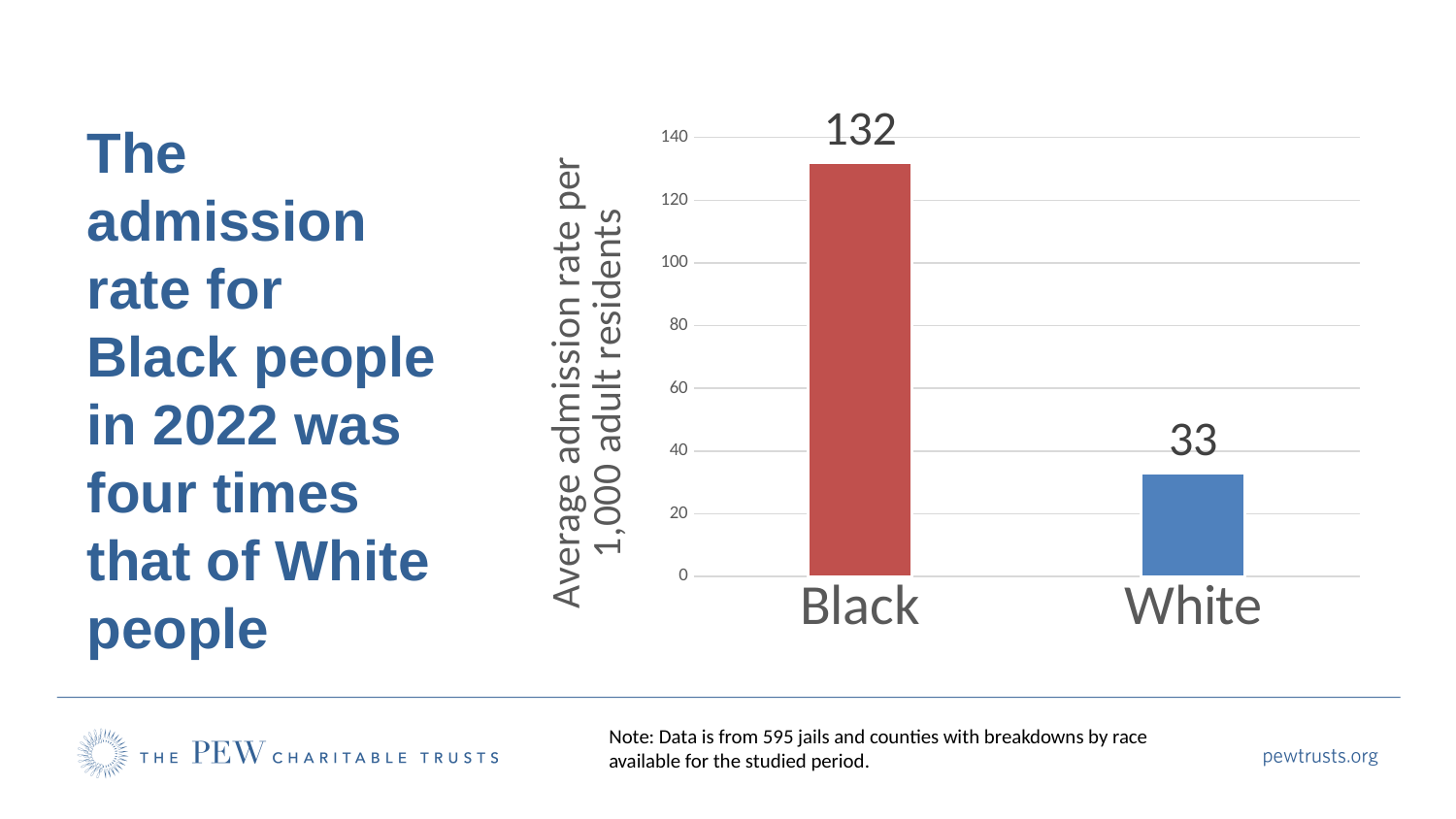
Which category has the highest admission rate? Black Is the admission rate for Black people greater or less than 120? greater What is the difference between the admission rates for Black and White people? 99 What kind of chart is shown on the slide? bar chart Which is larger, the admission rate for Black people or for White people? Black How many categories are shown on the chart? 2 What is the average admission rate per 1,000 adult residents for White people? 33 Which category has the lowest admission rate? White What is the label of the vertical axis? Average admission rate per 1,000 adult residents Is the admission rate for White people greater or less than 40? less What is the average admission rate per 1,000 adult residents for Black people? 132 What colour is the bar for Black people? red